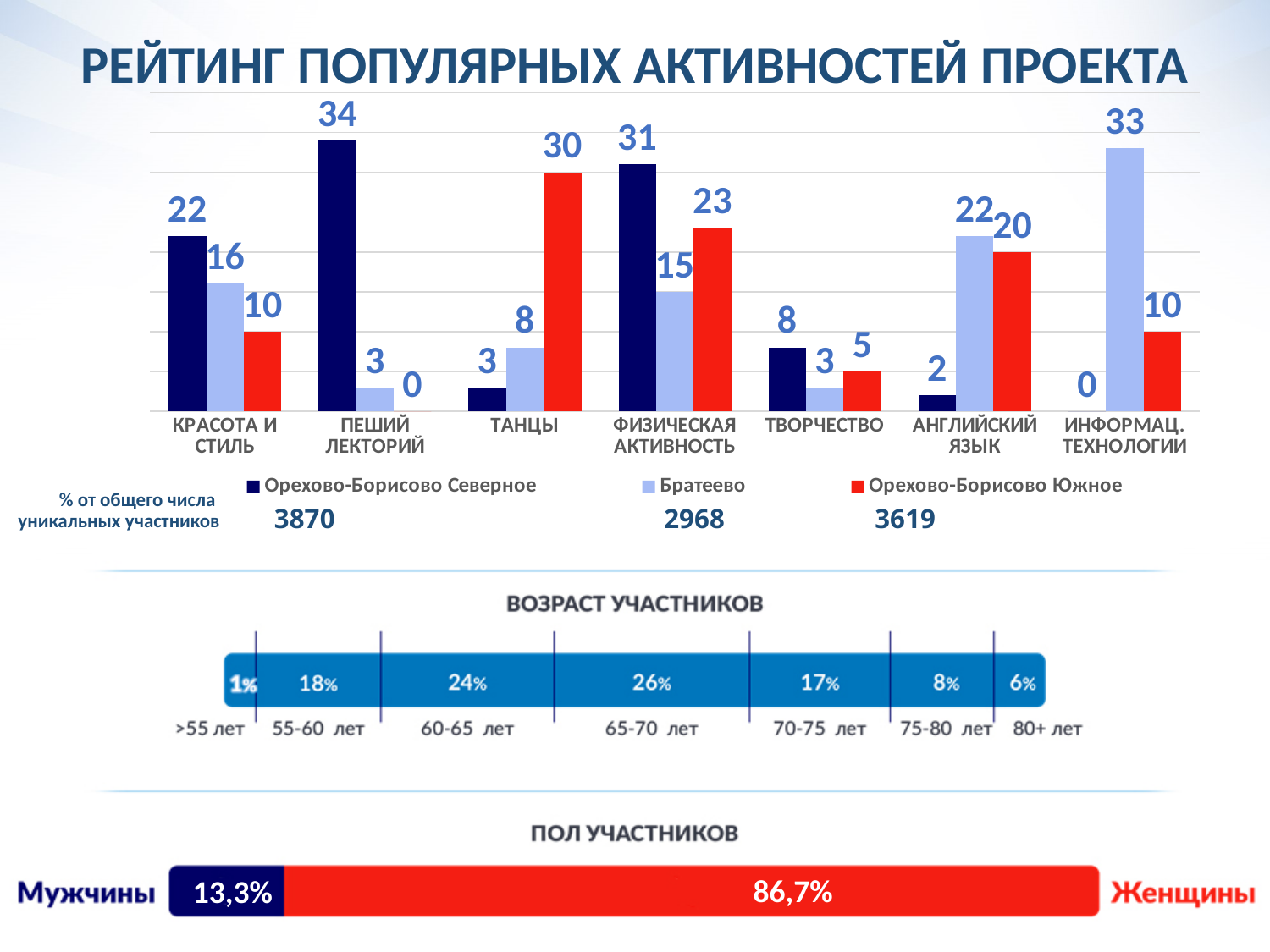
In the chart 'Рейтинг популярных активностей проекта', which category has the lowest value for Братеево? Пеший лекторий and Творчество (both 3) In the chart 'Рейтинг популярных активностей проекта', which is larger in the category 'Английский язык': Братеево or Орехово-Борисово Южное? Братеево In the chart 'Рейтинг популярных активностей проекта', what is the value for Орехово-Борисово Южное in the category 'Физическая активность'? 23 In the chart 'Рейтинг популярных активностей проекта', what is the difference between Орехово-Борисово Южное and Орехово-Борисово Северное in the category 'Танцы'? 27 In the chart 'Рейтинг популярных активностей проекта', what is the value for Братеево in the category 'Танцы'? 8 In the 'Возраст участников' chart, what is the share of participants aged 65-70 лет? 26% How many categories are shown on the x axis of the chart 'Рейтинг популярных активностей проекта'? 7 What kind of chart is 'Рейтинг популярных активностей проекта'? Bar chart In the 'Пол участников' chart, what is the share of Мужчины? 13,3% In the chart 'Рейтинг популярных активностей проекта', which series is shown in red? Орехово-Борисово Южное How many series does the legend of the chart 'Рейтинг популярных активностей проекта' list? 3 In the chart 'Рейтинг популярных активностей проекта', which category has the highest value for Орехово-Борисово Северное? Пеший лекторий